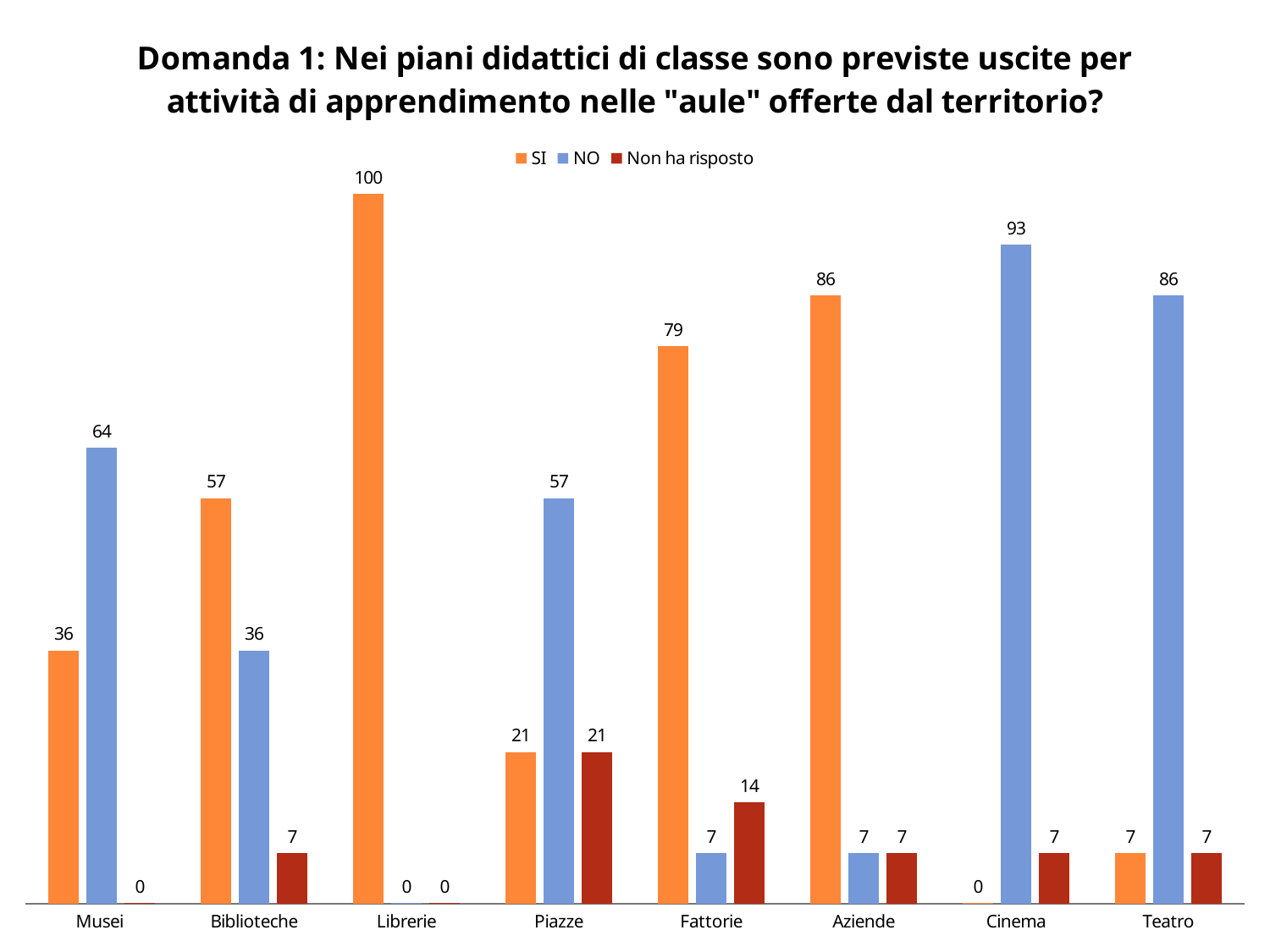
What is the Non ha risposto value for Piazze? 21 How many series does the legend list? 3 What kind of chart is shown on the slide? Bar chart Which colour represents the NO series in the legend? Blue What is the NO value for Cinema? 93 Which category has the highest SI value? Librerie What is the Non ha risposto value for Fattorie? 14 What is the SI value for Librerie? 100 Which category has the lowest NO value? Librerie Which is larger for Fattorie, the SI value or the NO value? SI What is the difference between the NO value and the SI value for Musei? 28 How many categories are shown on the x axis? 8